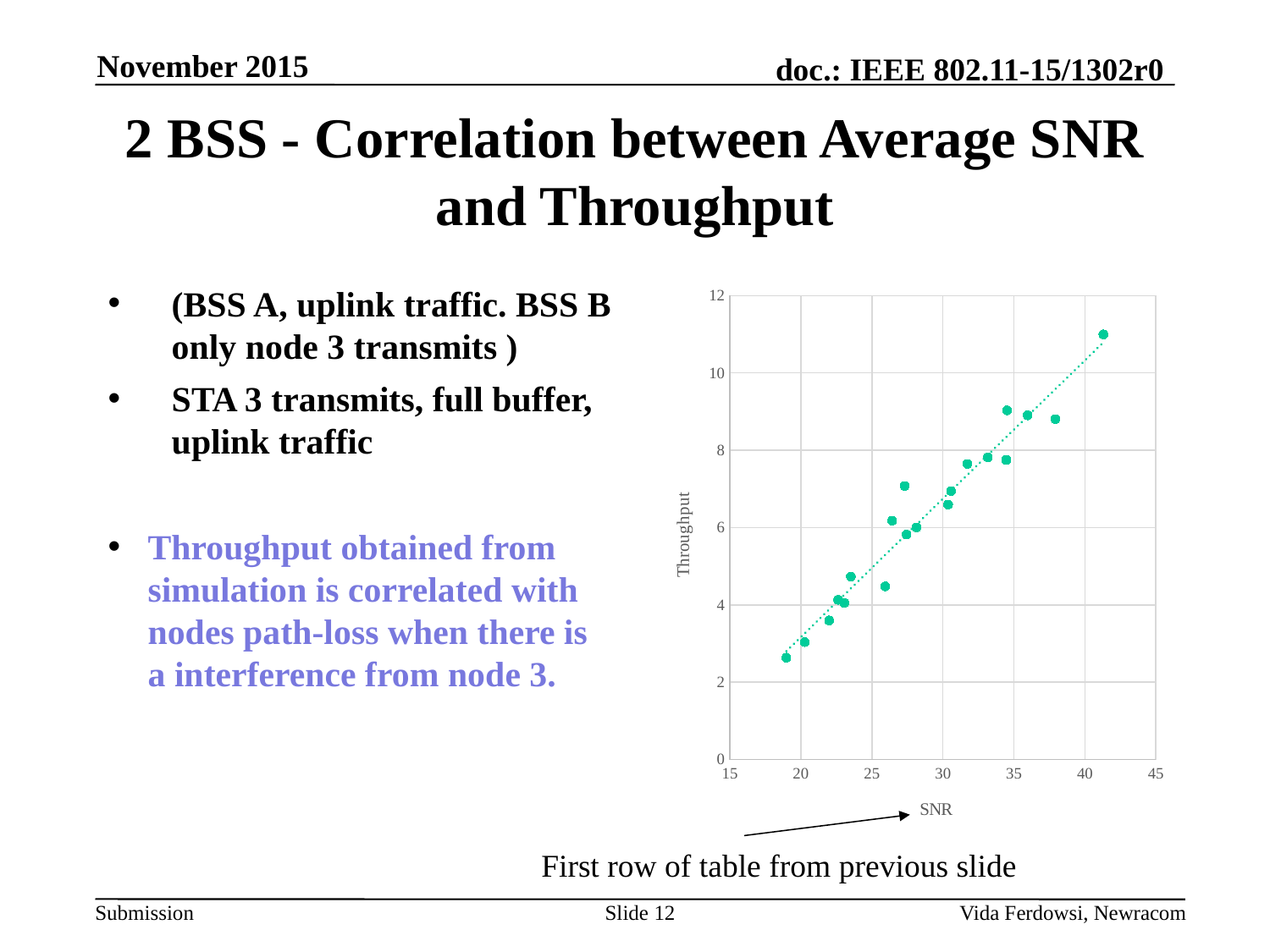
As SNR increases along the x axis, does throughput generally rise or fall? Rise Does the point with the highest throughput also have the highest SNR? Yes What is the maximum value shown on the x axis of the chart? 45 Is the throughput of the point with the highest SNR greater or less than 10? greater What is the label of the y axis of the chart? Throughput Is the throughput of the points near SNR 35 greater or less than 6? greater What is the label of the x axis of the chart? SNR Is the throughput of the points near SNR 30 greater or less than 8? less What kind of chart is shown on the slide? Scatter chart Which has higher throughput: the point near SNR 20 or the point near SNR 40? The point near SNR 40